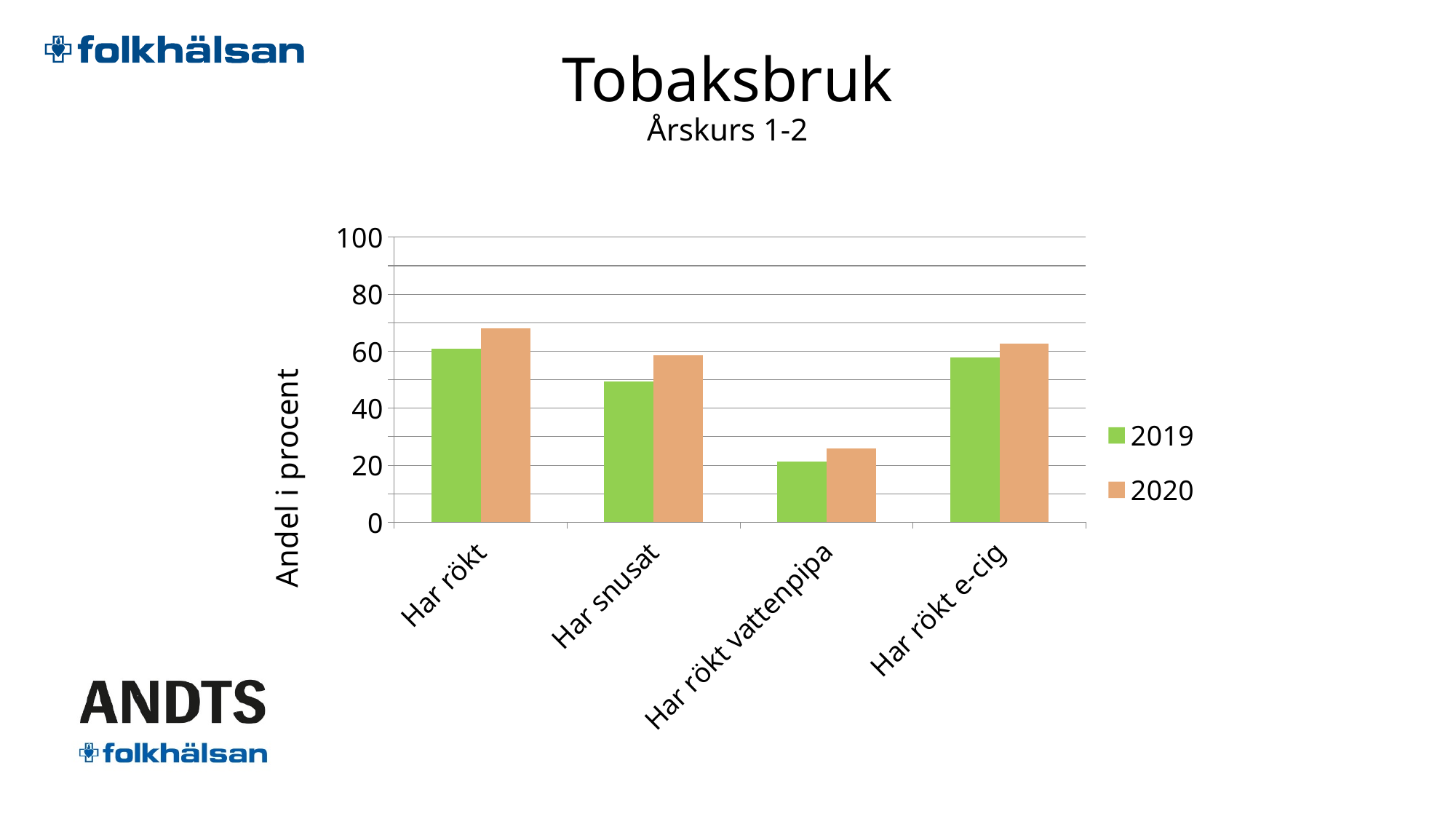
Which is larger for 2020: the value for Har rökt e-cig or the value for Har rökt vattenpipa? Har rökt e-cig Which is larger for 2019: the value for Har rökt or the value for Har snusat? Har rökt Which colour represents the 2020 series in the legend? Orange Which category has the highest value for 2020? Har rökt How many categories are shown on the x axis of the chart? 4 How many series does the legend list? 2 Is the 2020 value for Har rökt greater or less than 60? greater What kind of chart is shown on the slide? Bar chart What is the title of the y axis? Andel i procent Is the 2019 value for Har snusat greater or less than 60? less Which category has the lowest value for 2019? Har rökt vattenpipa Is the 2019 value for Har rökt vattenpipa greater or less than 40? less